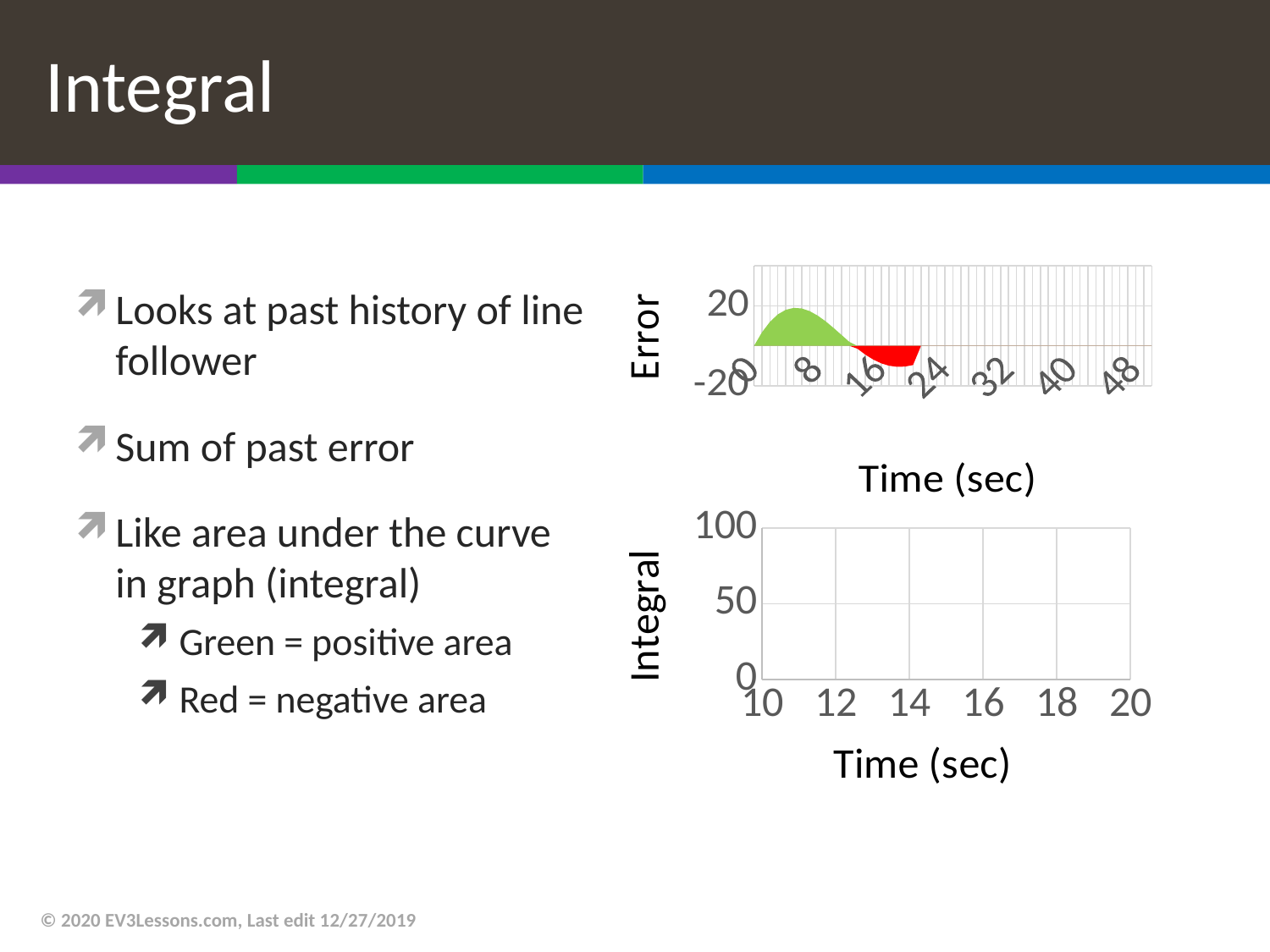
What is the y-axis label of the bottom chart? Integral What kind of chart is the top chart (Error vs Time)? area chart In the top Error chart, is the error at time 20 greater or less than 0? less In the top Error chart, is the error at time 8 greater or less than 20? less In the top Error chart, what colour is the area where the error is negative? red How many tick labels are shown on the x axis of the bottom Integral chart? 6 How many tick labels are shown on the x axis of the top Error chart? 7 In the top Error chart, is the error at time 8 greater or less than 0? greater In the top Error chart, does the error rise or fall between time 8 and time 16? fall In the top Error chart, does the error rise or fall between time 0 and time 8? rise